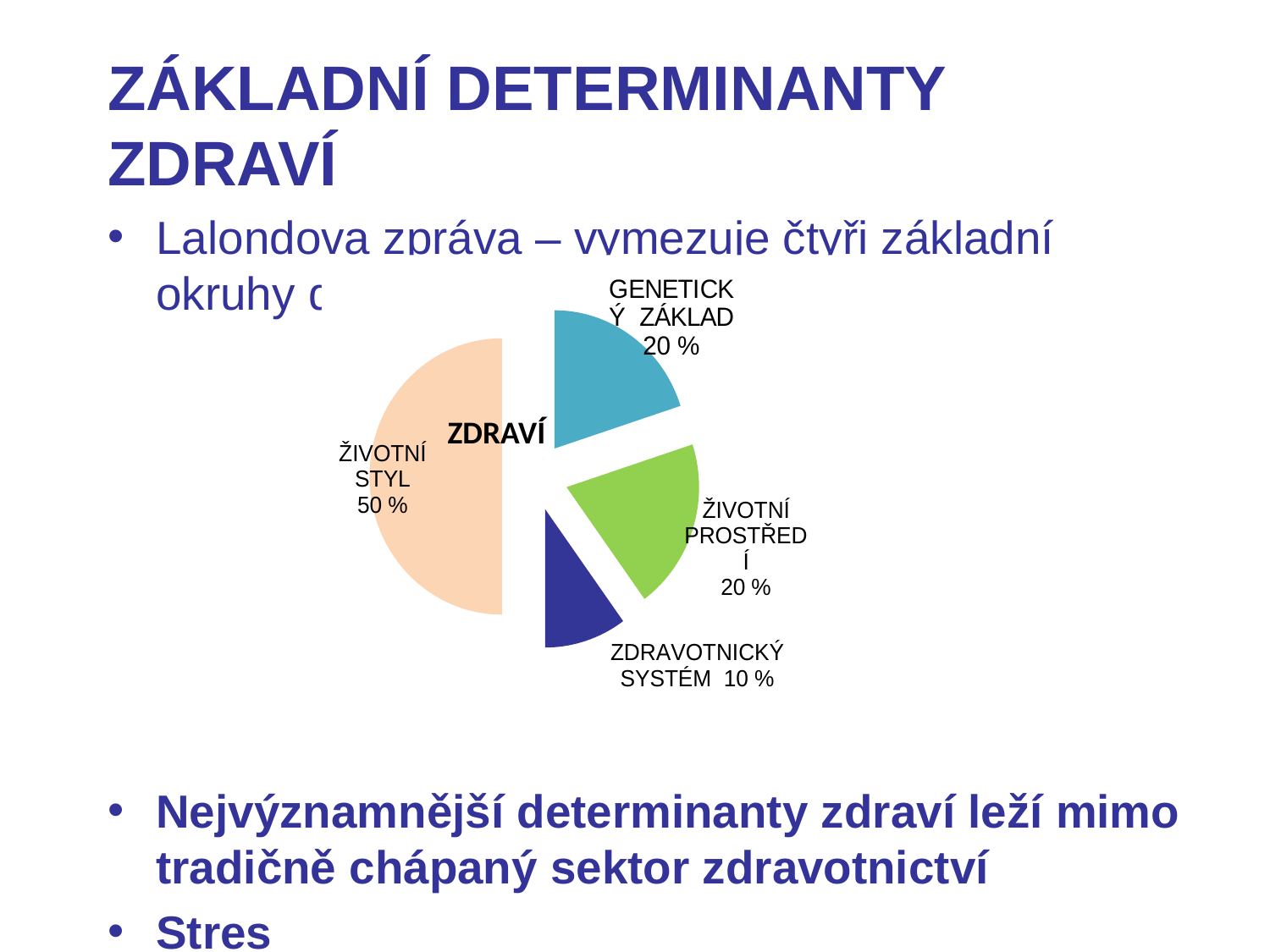
What share of the pie does ŽIVOTNÍ PROSTŘEDÍ have? 20 % Which slice of the pie chart is the smallest? ZDRAVOTNICKÝ SYSTÉM Which is larger, the share of GENETICKÝ ZÁKLAD or the share of ZDRAVOTNICKÝ SYSTÉM? GENETICKÝ ZÁKLAD What kind of chart is shown on the slide? pie chart What share of the pie does GENETICKÝ ZÁKLAD have? 20 % What colour is the ŽIVOTNÍ PROSTŘEDÍ slice of the pie chart? green What is the difference between the shares of ŽIVOTNÍ STYL and ZDRAVOTNICKÝ SYSTÉM? 40 % What label is written in the centre of the pie chart? ZDRAVÍ Which slice of the pie chart is the largest? ŽIVOTNÍ STYL What share of the pie does ŽIVOTNÍ STYL have? 50 % How many slices does the pie chart have? 4 What share of the pie does ZDRAVOTNICKÝ SYSTÉM have? 10 %